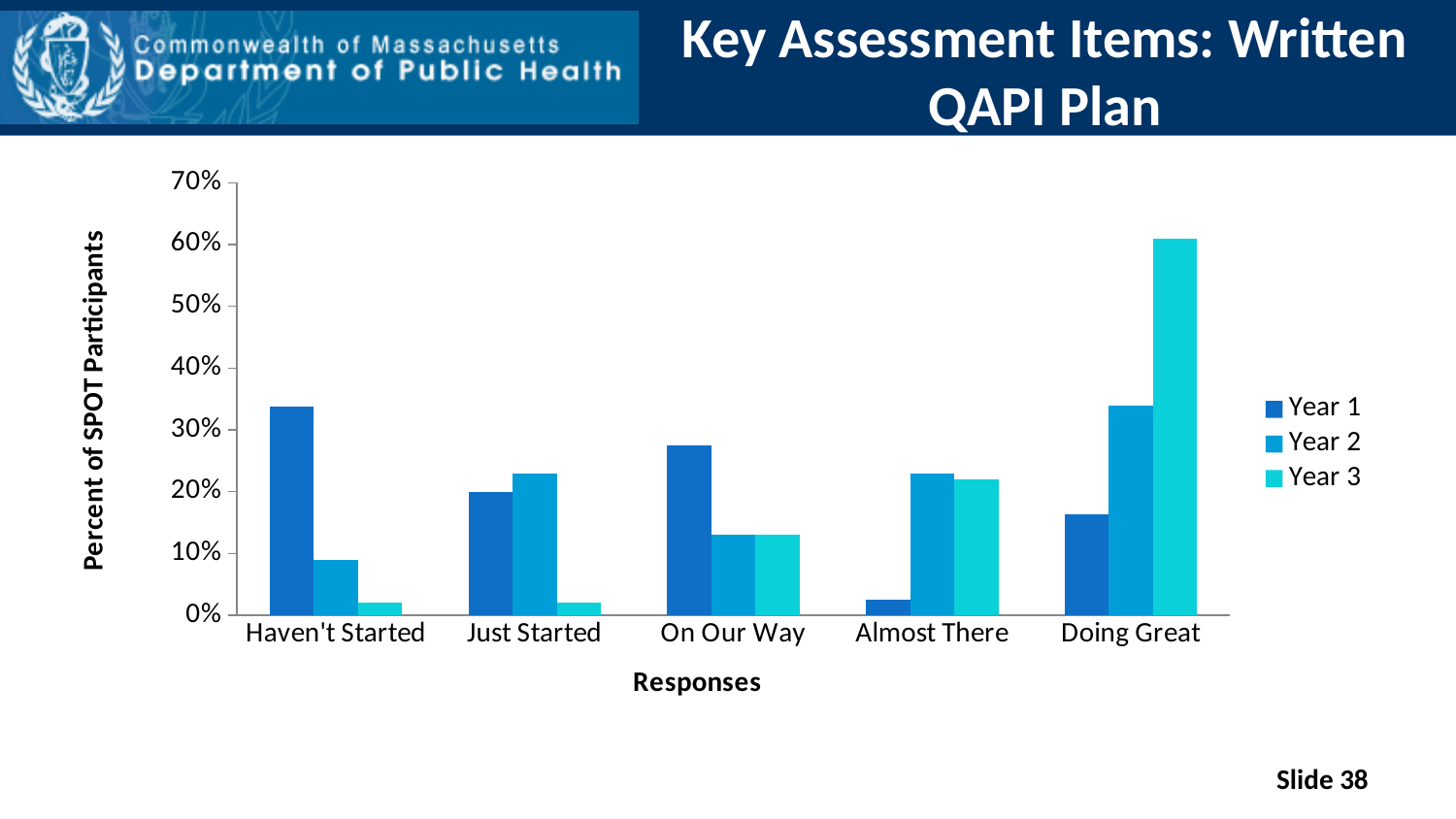
Is the Year 3 value for Doing Great greater or less than 50%? greater Is the Year 1 value for Almost There greater or less than 10%? less How many series does the legend list? 3 What kind of chart is shown on the slide? bar chart Is the Year 1 value for Haven't Started greater or less than 30%? greater For Year 3, which response category has the highest value? Doing Great What is the title of the vertical axis? Percent of SPOT Participants For Haven't Started, which is larger: Year 1 or Year 2? Year 1 For Year 1, which response category has the lowest value? Almost There How many response categories are shown on the x axis? 5 For Year 1, which response category has the highest value? Haven't Started For Doing Great, which is larger: Year 2 or Year 3? Year 3